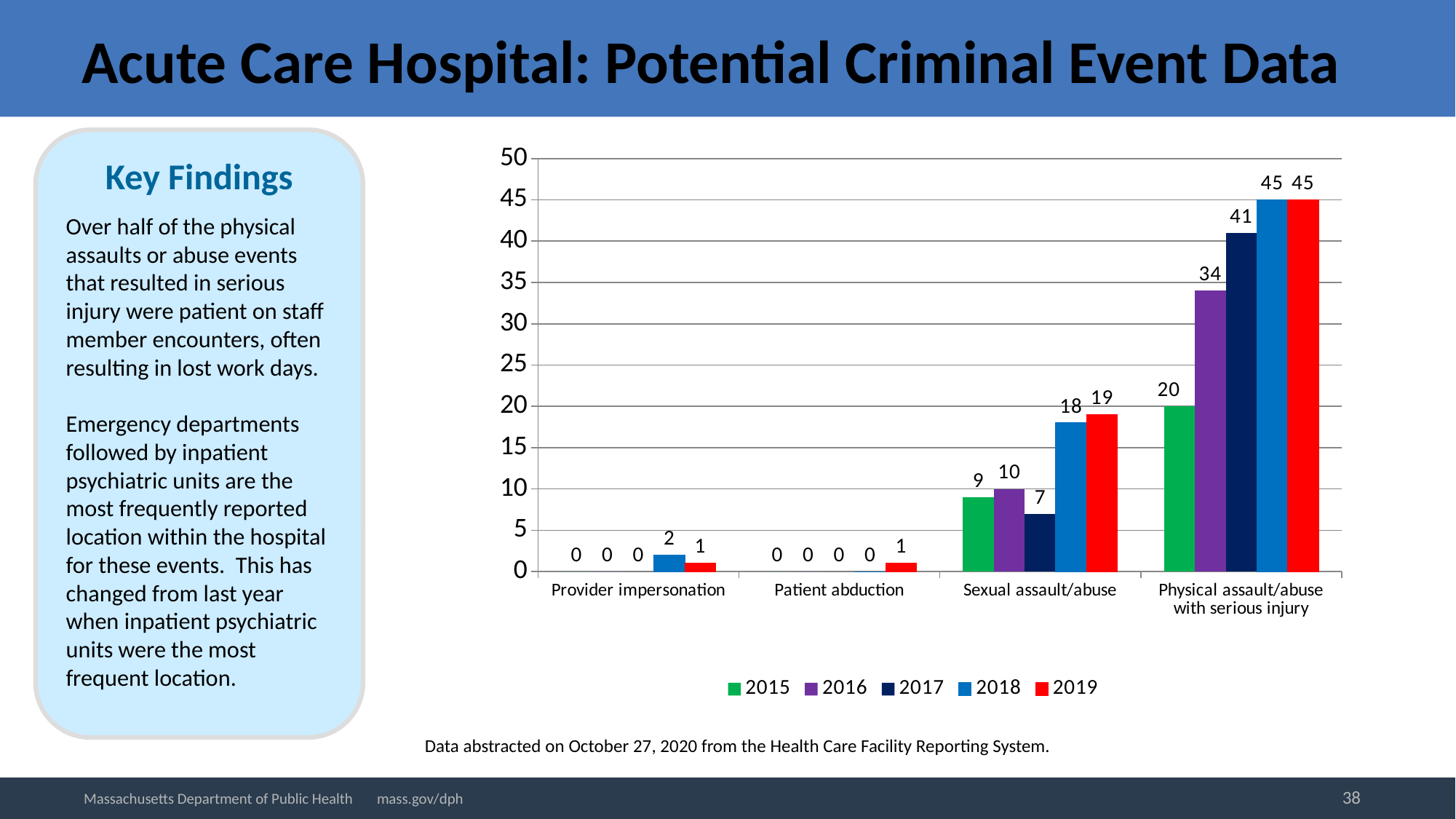
What is the value for 2019 in the Patient abduction category? 1 What is the value for 2019 in the Physical assault/abuse with serious injury category? 45 Do the values for the Physical assault/abuse with serious injury category rise or fall from 2015 to 2018? Rise What is the value for 2018 in the Provider impersonation category? 2 Which year has the lowest value in the Physical assault/abuse with serious injury category? 2015 Which is larger in the Sexual assault/abuse category: the 2016 value or the 2018 value? 2018 What is the value for 2017 in the Sexual assault/abuse category? 7 How many categories are shown on the x axis? 4 What kind of chart is shown on the slide? Bar chart Which category has the highest value for 2016? Physical assault/abuse with serious injury What is the difference between the 2016 and 2015 values in the Physical assault/abuse with serious injury category? 14 How many series does the legend list? 5